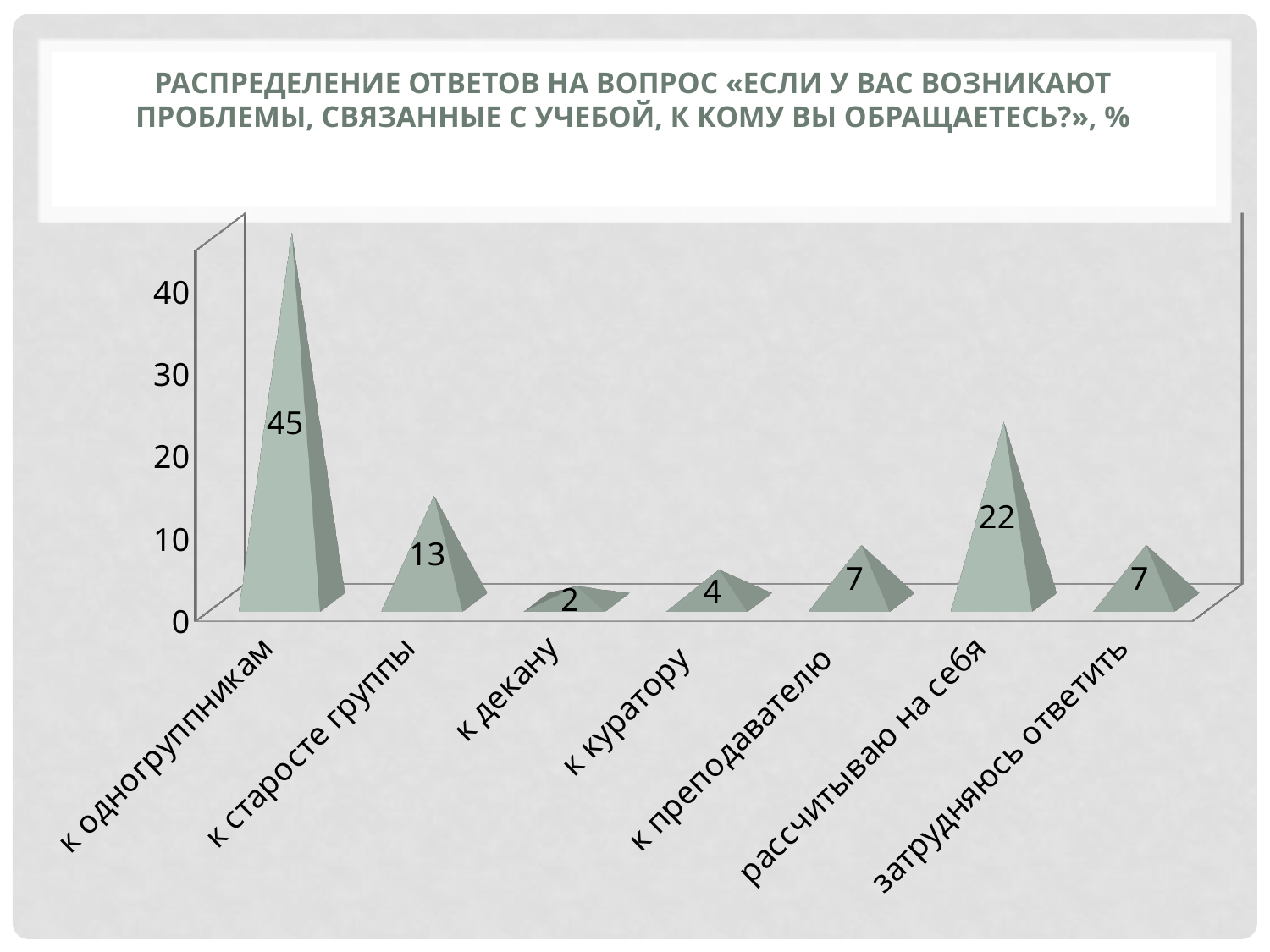
Which category has the lowest value? к декану What is the difference between the values for «к одногруппникам» and «рассчитываю на себя»? 23 What kind of chart is this? bar chart What value is shown for «к старосте группы»? 13 How many categories are shown on the x axis? 7 Which category has the highest value? к одногруппникам What value is shown for «рассчитываю на себя»? 22 What is the highest tick value shown on the vertical axis? 40 What value is shown for «к одногруппникам»? 45 Which is larger, the value for «к старосте группы» or the value for «к преподавателю»? к старосте группы What value is shown for «к куратору»? 4 What is the difference between the values for «к преподавателю» and «к декану»? 5